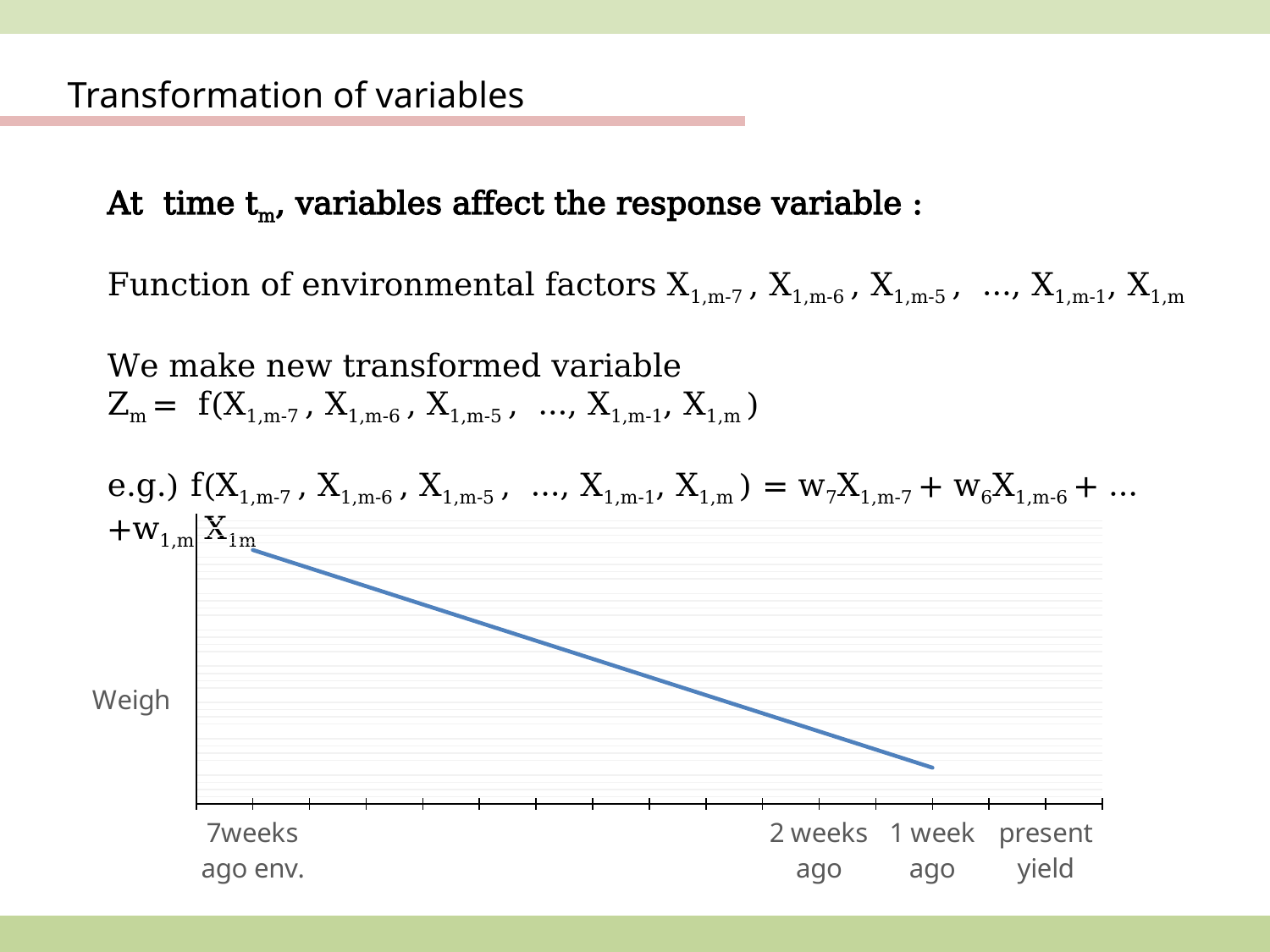
How many labelled positions are shown on the x axis of the chart? 4 How many lines are plotted on the chart? 1 At which labelled x-axis position is the plotted weight highest? 7weeks ago env. What is the label at the far right end of the x axis? present yield What kind of chart is shown on the slide? line chart At which labelled x-axis position does the plotted line reach its lowest point? 1 week ago Which is larger, the weight at '7weeks ago env.' or the weight at '1 week ago'? 7weeks ago env. Does the plotted line rise or fall as it moves from '7weeks ago env.' toward 'present yield'? fall What is the label on the vertical axis of the chart? Weigh Which is larger, the weight at '2 weeks ago' or the weight at '1 week ago'? 2 weeks ago